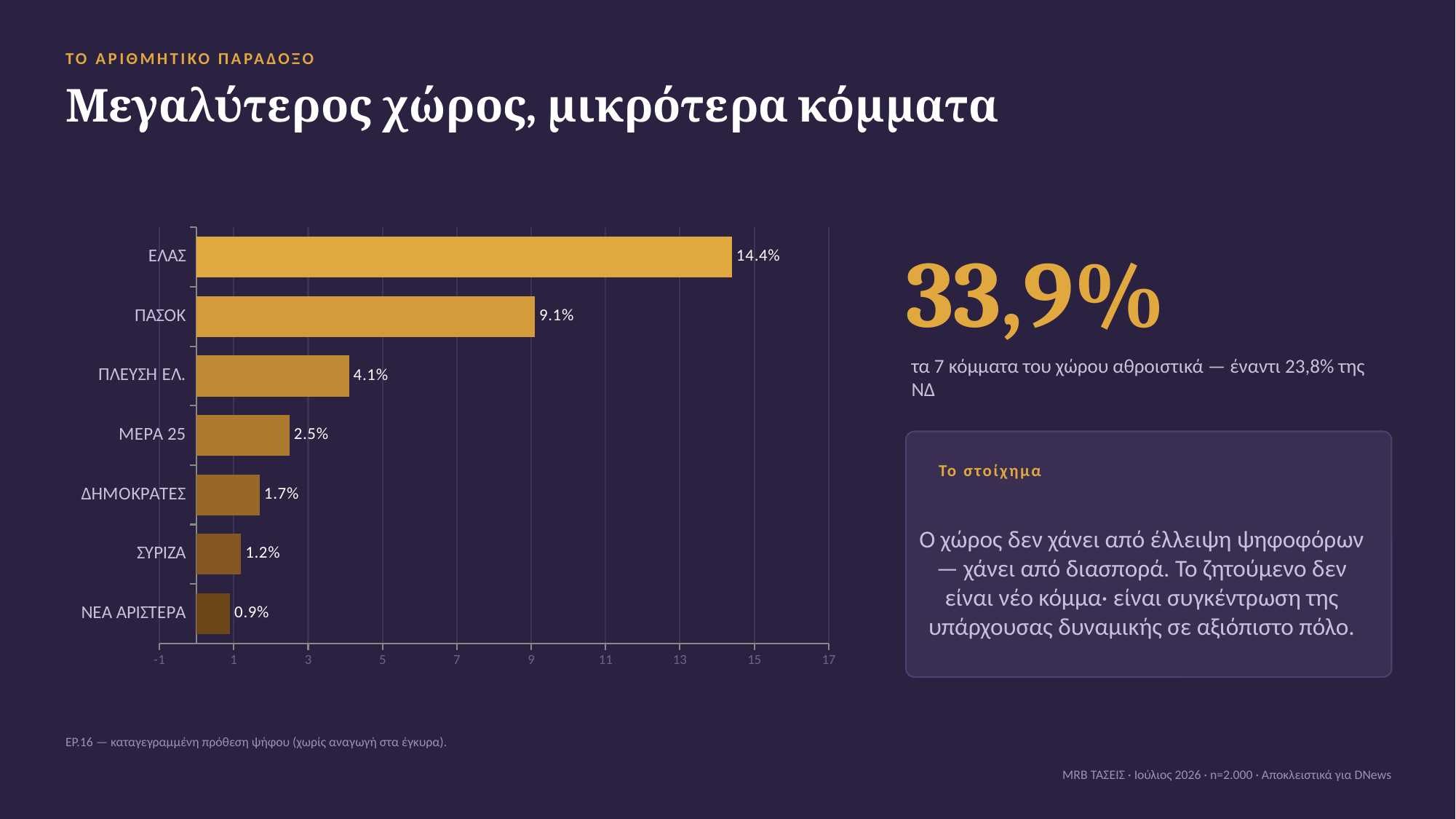
How many parties are shown in the bar chart? 7 Which party has the lowest value in the bar chart? ΝΕΑ ΑΡΙΣΤΕΡΑ Which party has the highest value in the bar chart? ΕΛΑΣ What kind of chart is shown on the slide? Bar chart Which has a larger value, ΔΗΜΟΚΡΑΤΕΣ or ΣΥΡΙΖΑ? ΔΗΜΟΚΡΑΤΕΣ What is the value shown for ΝΕΑ ΑΡΙΣΤΕΡΑ in the bar chart? 0.9% What is the value shown for ΜΕΡΑ 25 in the bar chart? 2.5% Is the value for ΠΑΣΟΚ greater or less than 7? greater What is the value shown for ΕΛΑΣ in the bar chart? 14.4% What is the difference between the values for ΕΛΑΣ and ΠΑΣΟΚ? 5.3% What is the difference between the values for ΠΛΕΥΣΗ ΕΛ. and ΜΕΡΑ 25? 1.6% What is the value shown for ΠΑΣΟΚ in the bar chart? 9.1%